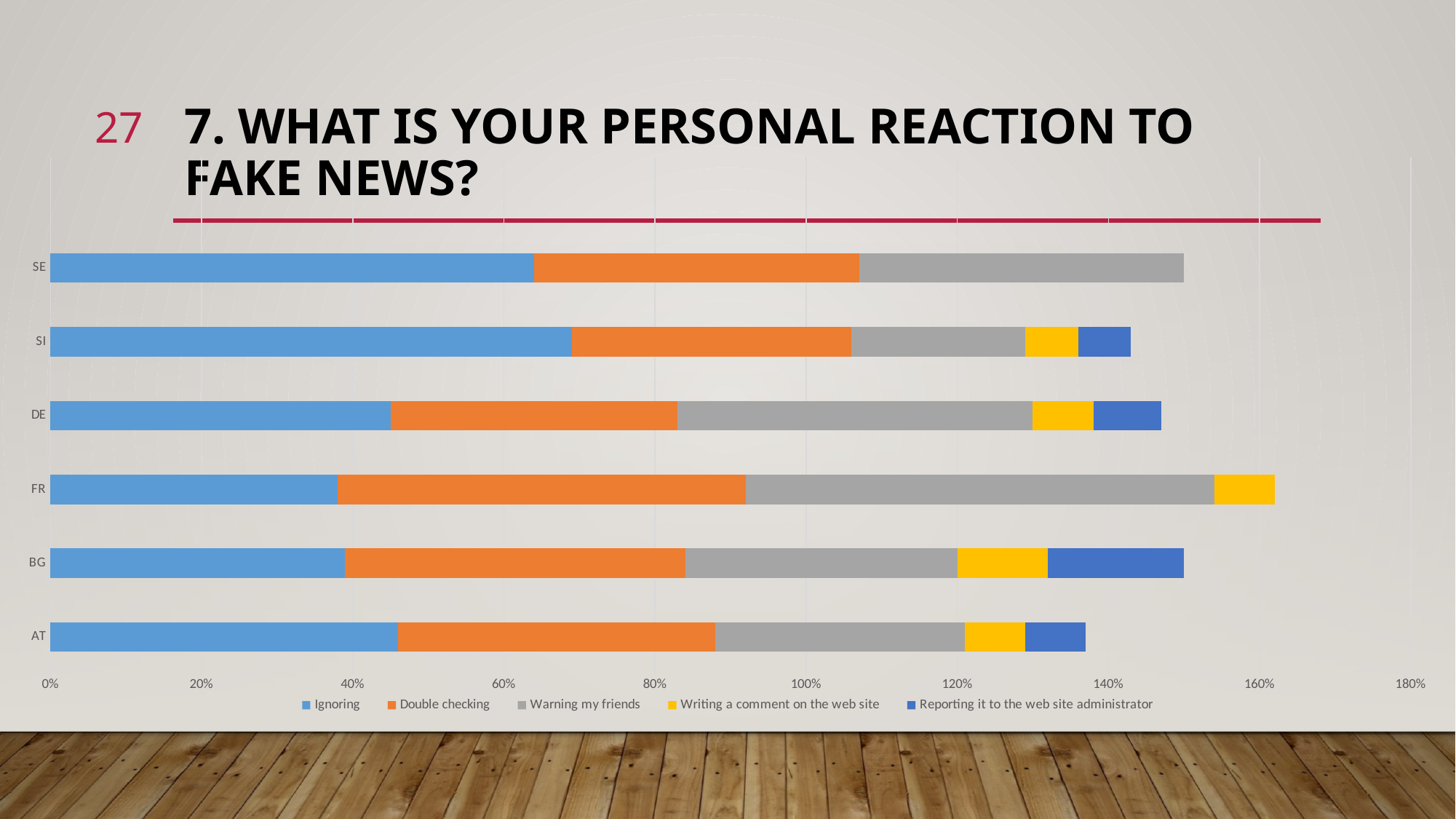
Is the 'Ignoring' value for SE greater or less than 60%? greater Is the total of the stacked bar for FR greater or less than 140%? greater Is the 'Ignoring' value for DE greater or less than 60%? less How many countries (categories) are shown on the chart? 6 Which country has the longest total stacked bar? FR What colour represents 'Double checking' in the legend? Orange How many series does the legend list? 5 Which is larger, the 'Ignoring' segment for SE or for DE? SE Which country's bar has no 'Writing a comment on the web site' or 'Reporting it to the web site administrator' segment? SE Which country has the largest 'Ignoring' segment? SI What kind of chart is shown on the slide? Stacked bar chart